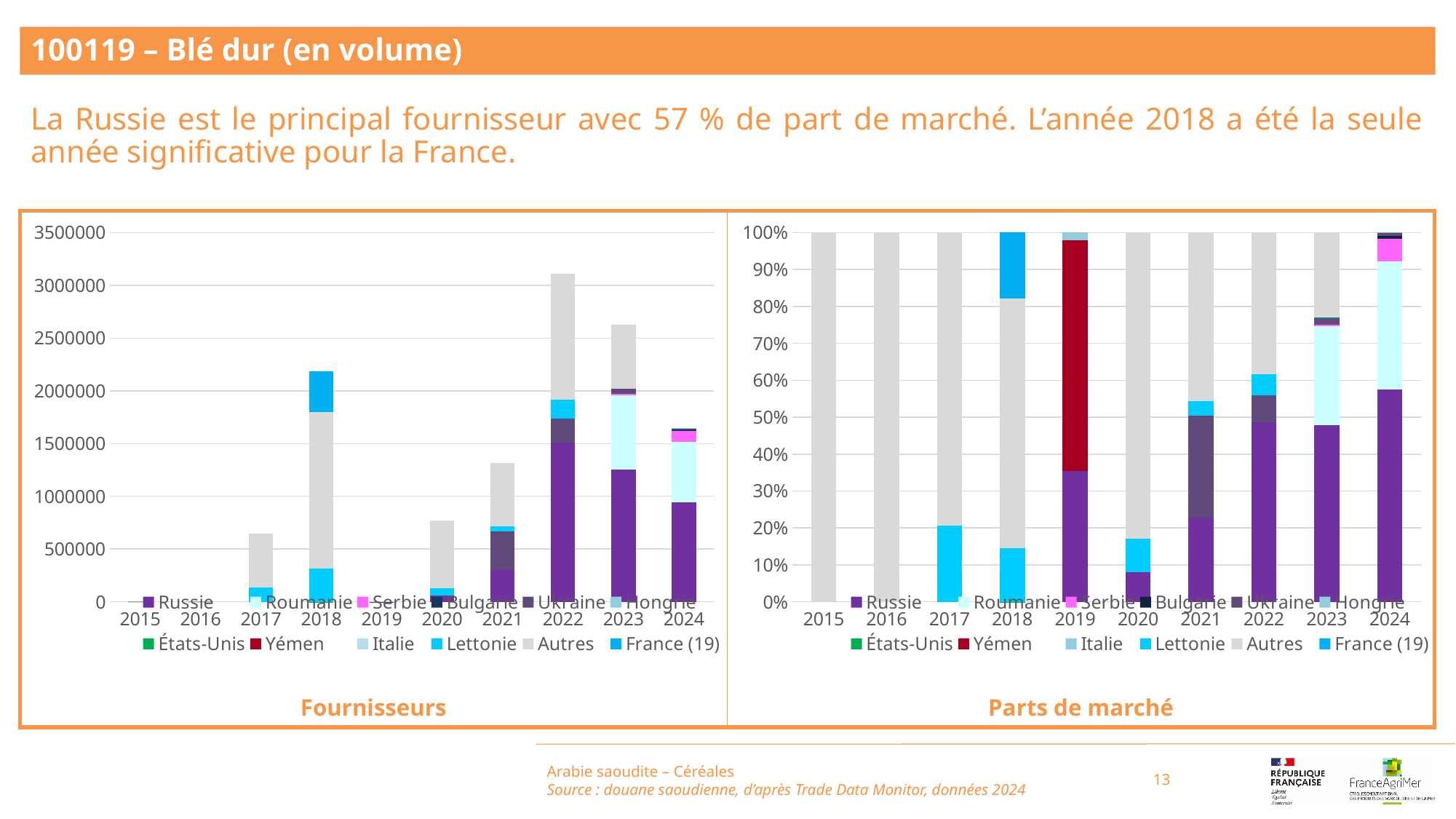
How many years are shown on the x axis of the 'Fournisseurs' chart? 10 In the 'Parts de marché' chart, is the share of Russie in 2024 greater or less than 50%? greater In the 'Fournisseurs' chart, is the total for 2018 greater or less than 2000000? greater In the 'Parts de marché' chart, which series accounts for the largest share in 2019? Yémen In the 'Fournisseurs' chart, is the total for 2017 greater or less than 1000000? less What is the title of the chart on the right? Parts de marché What kind of chart is the 'Fournisseurs' chart on the left? stacked bar chart How many series does the legend of the 'Parts de marché' chart list? 12 In the 'Fournisseurs' chart, which year has the highest total bar? 2022 In the 'Fournisseurs' chart, which total is larger, 2022 or 2023? 2022